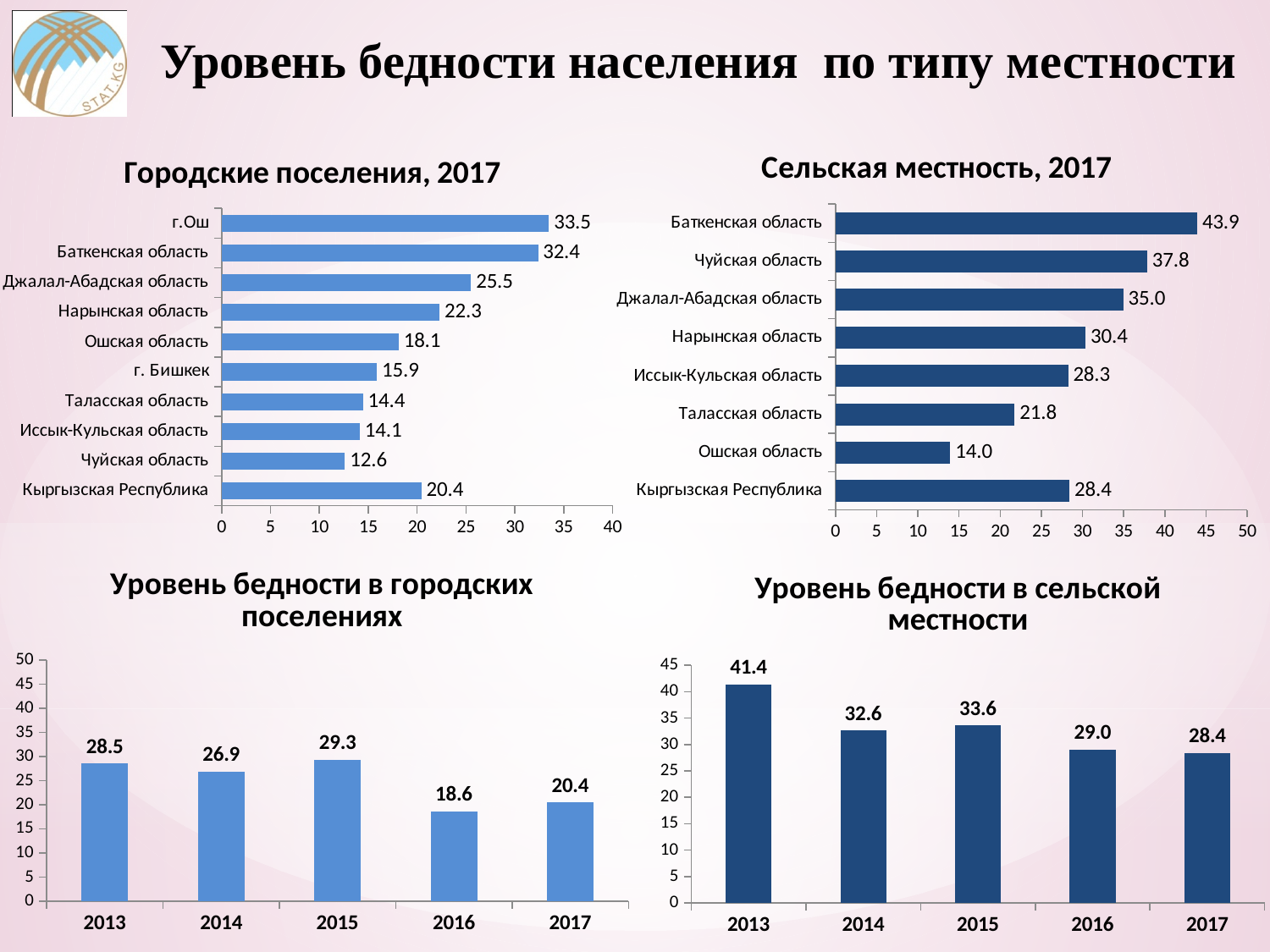
In the chart titled 'Уровень бедности в городских поселениях', which is larger, the value for 2014 or the value for 2015? 2015 In the chart titled 'Городские поселения, 2017', how many categories are shown? 10 In the chart titled 'Уровень бедности в городских поселениях', how many years are shown? 5 What kind of chart is the one titled 'Уровень бедности в сельской местности'? bar chart In the chart titled 'Городские поселения, 2017', what is the value for г.Ош? 33.5 In the chart titled 'Уровень бедности в сельской местности', which year has the highest value? 2013 In the chart titled 'Сельская местность, 2017', what is the value for Кыргызская Республика? 28.4 In the chart titled 'Уровень бедности в городских поселениях', what is the value for 2016? 18.6 In the chart titled 'Сельская местность, 2017', which region has the lowest value? Ошская область In the chart titled 'Сельская местность, 2017', which region has the highest value? Баткенская область In the chart titled 'Уровень бедности в сельской местности', what is the difference between the values for 2013 and 2017? 13.0 In the chart titled 'Городские поселения, 2017', what is the difference between the values for г.Ош and Чуйская область? 20.9